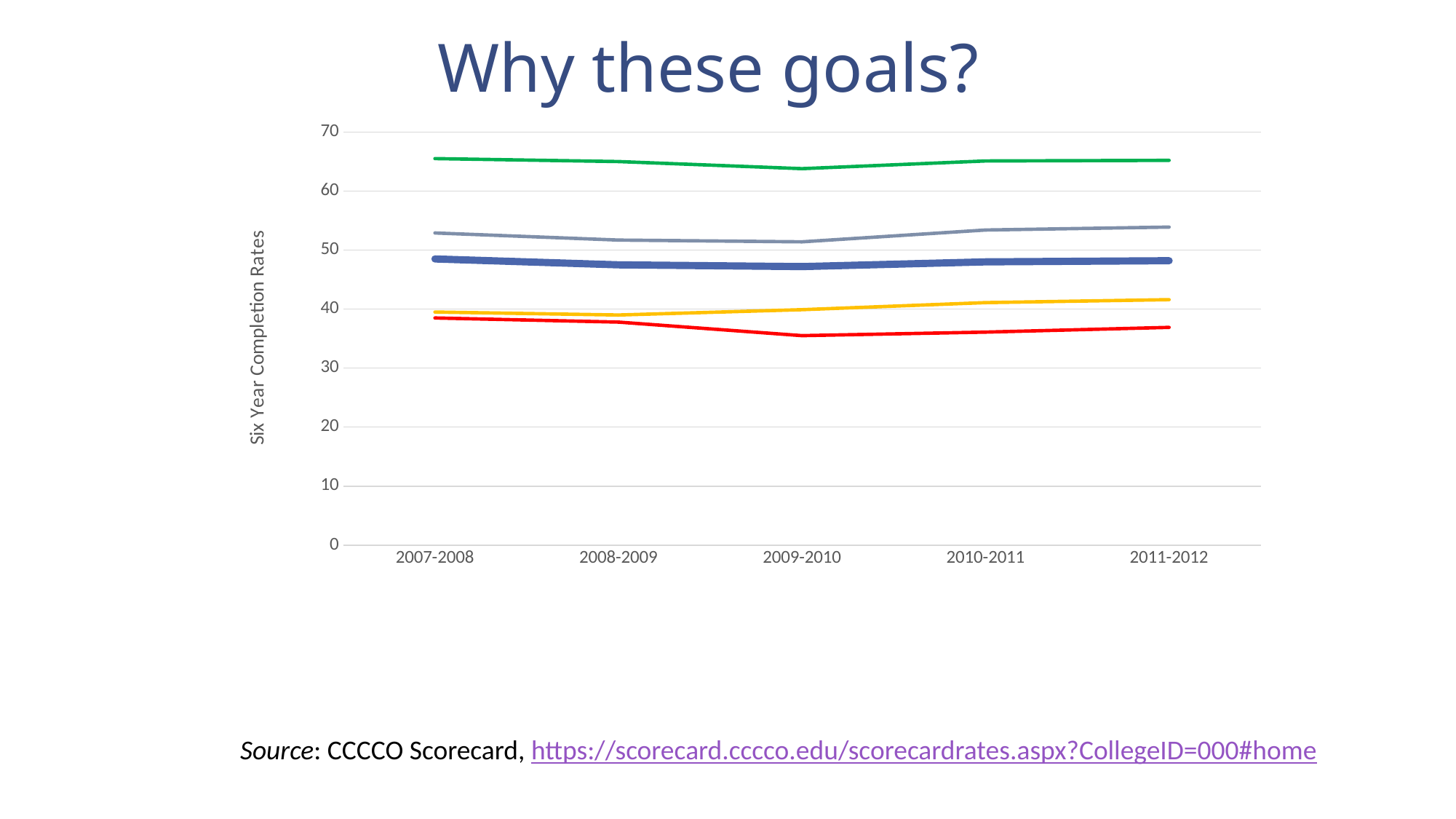
Which line in the chart has the lowest completion rate in 2011-2012? the red line Is the value of the red line in 2009-2010 greater or less than 40? less How many academic years are shown along the x axis of the chart? 5 What kind of chart is shown on the slide? line chart Is the value of the yellow line in 2011-2012 greater or less than 40? greater Is the value of the thick dark blue line in 2011-2012 greater or less than 50? less Which line in the chart has the highest completion rates across all years? the green line In 2011-2012, which is higher: the yellow line or the red line? the yellow line What is the label on the vertical axis of the chart? Six Year Completion Rates Does the red line rise or fall between 2008-2009 and 2009-2010? fall Does the yellow line rise or fall between 2009-2010 and 2011-2012? rise